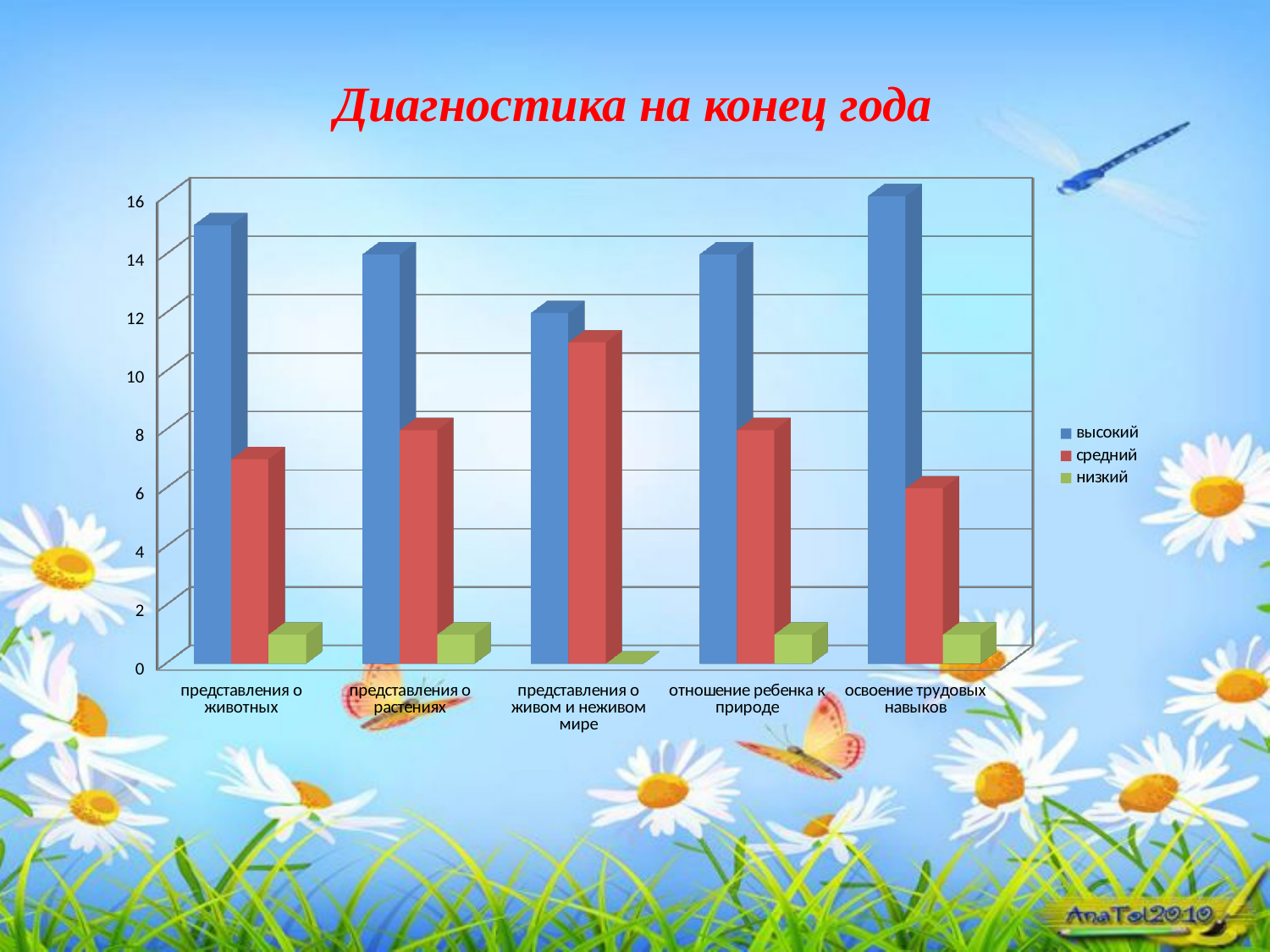
Is the value of низкий for представления о животных greater or less than 2? less Which category has the highest value for the series средний? представления о живом и неживом мире How many series does the legend list? 3 What is the title of the chart? Диагностика на конец года For представления о живом и неживом мире, which is larger: высокий or средний? высокий What kind of chart is shown on the slide? bar chart How many categories are shown on the x axis? 5 Which category has the lowest value for the series низкий? представления о живом и неживом мире Which category has the highest value for the series высокий? освоение трудовых навыков Is the value of средний for представления о живом и неживом мире greater or less than 10? greater Which category has the lowest value for the series высокий? представления о живом и неживом мире Is the value of высокий for представления о животных greater or less than 14? greater